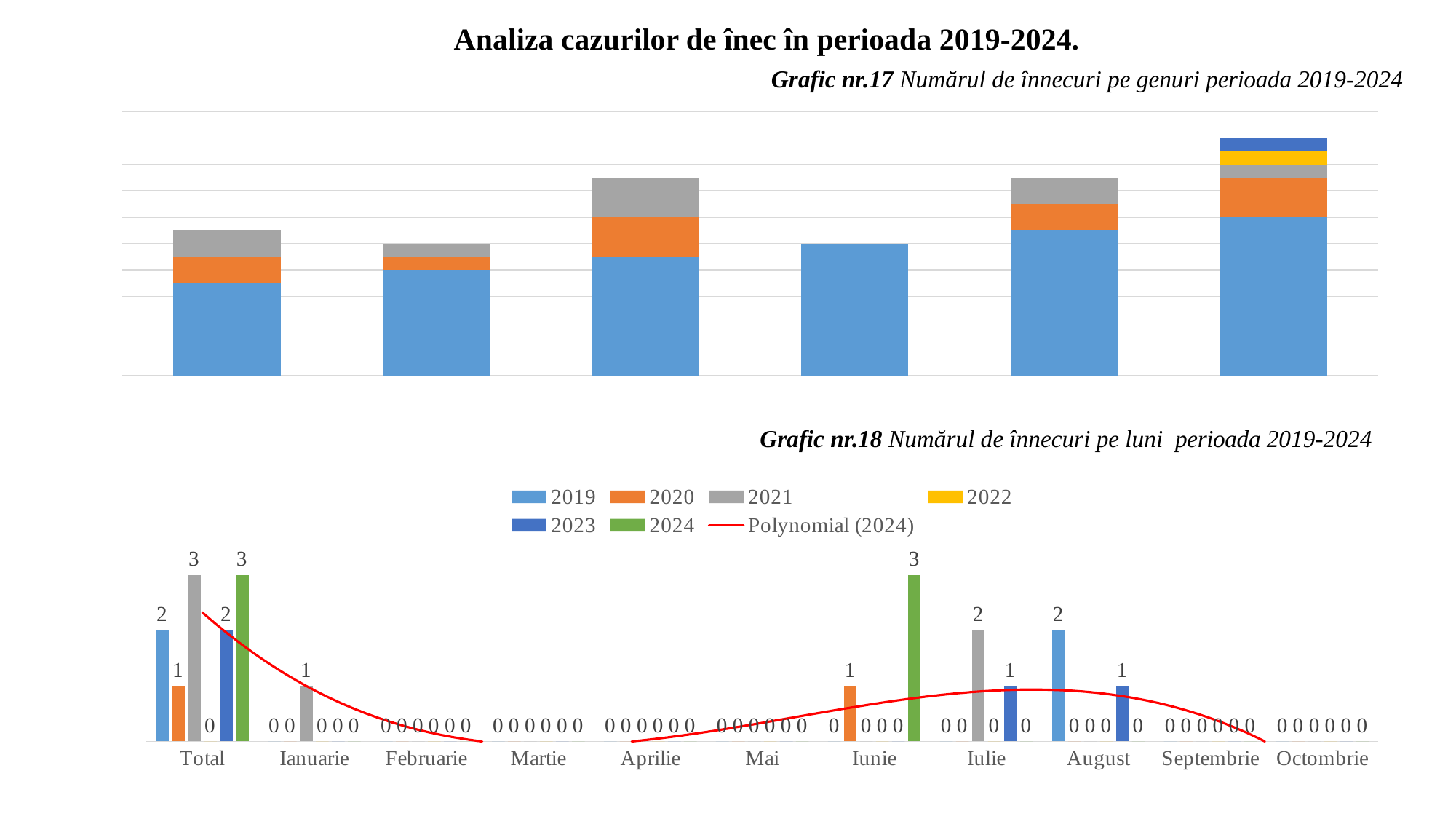
In Grafic nr.18, what is the value for 2019 in August? 2 In Grafic nr.18, what is the difference between the 2021 value and the 2020 value in the Total category? 2 What kind of chart is Grafic nr.17? Stacked bar chart In Grafic nr.18, what is the value for 2021 in Ianuarie? 1 In Grafic nr.18, what is the value for 2021 in the Total category? 3 How many bars are plotted in Grafic nr.17? 6 In Grafic nr.18, which is larger in the Total category: the value for 2019 or the value for 2020? 2019 In Grafic nr.18, how many entries does the legend list? 7 In Grafic nr.18, how many categories are shown on the x axis? 11 In Grafic nr.18, what is the value for 2024 in Iunie? 3 In Grafic nr.18, what is the value for 2021 in Iulie? 2 In Grafic nr.18, what is the value for 2020 in the Total category? 1